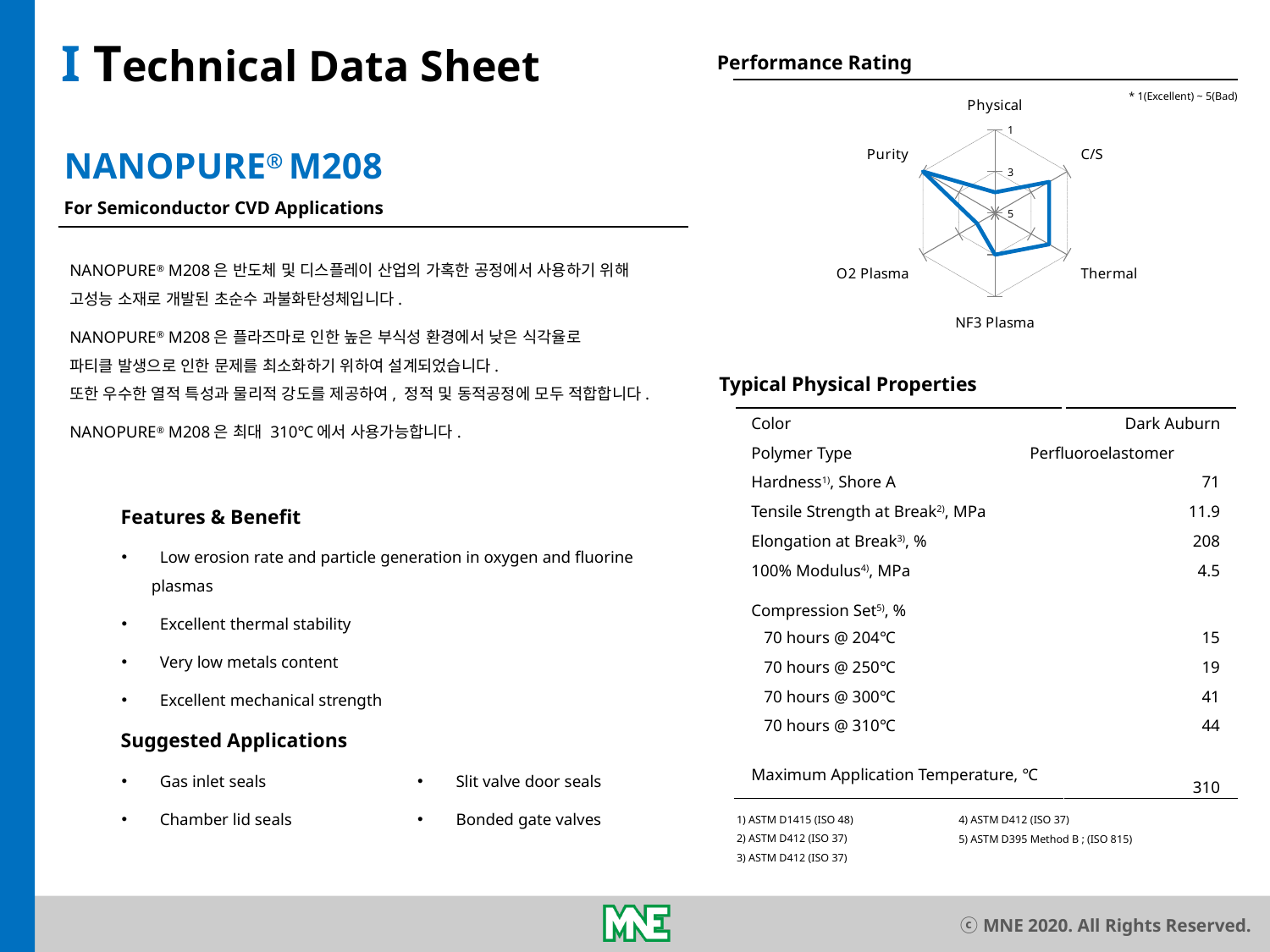
What rating scale note is printed next to the Performance Rating chart? 1(Excellent) ~ 5(Bad) In the Performance Rating chart, is the value for O2 Plasma greater or less than 3? greater What kind of chart is shown under "Performance Rating"? Radar chart What is the title of the chart on the slide? Performance Rating In the Performance Rating chart, is the value for C/S greater or less than 3? less In the Performance Rating chart, is the value for Thermal greater or less than 3? less In the Performance Rating chart, which has the higher numeric rating value, Purity or O2 Plasma? O2 Plasma How many categories (axes) does the Performance Rating radar chart have? 6 In the Performance Rating chart, which category has the highest numeric rating value (closest to 5)? Physical and O2 Plasma (tied at 4)